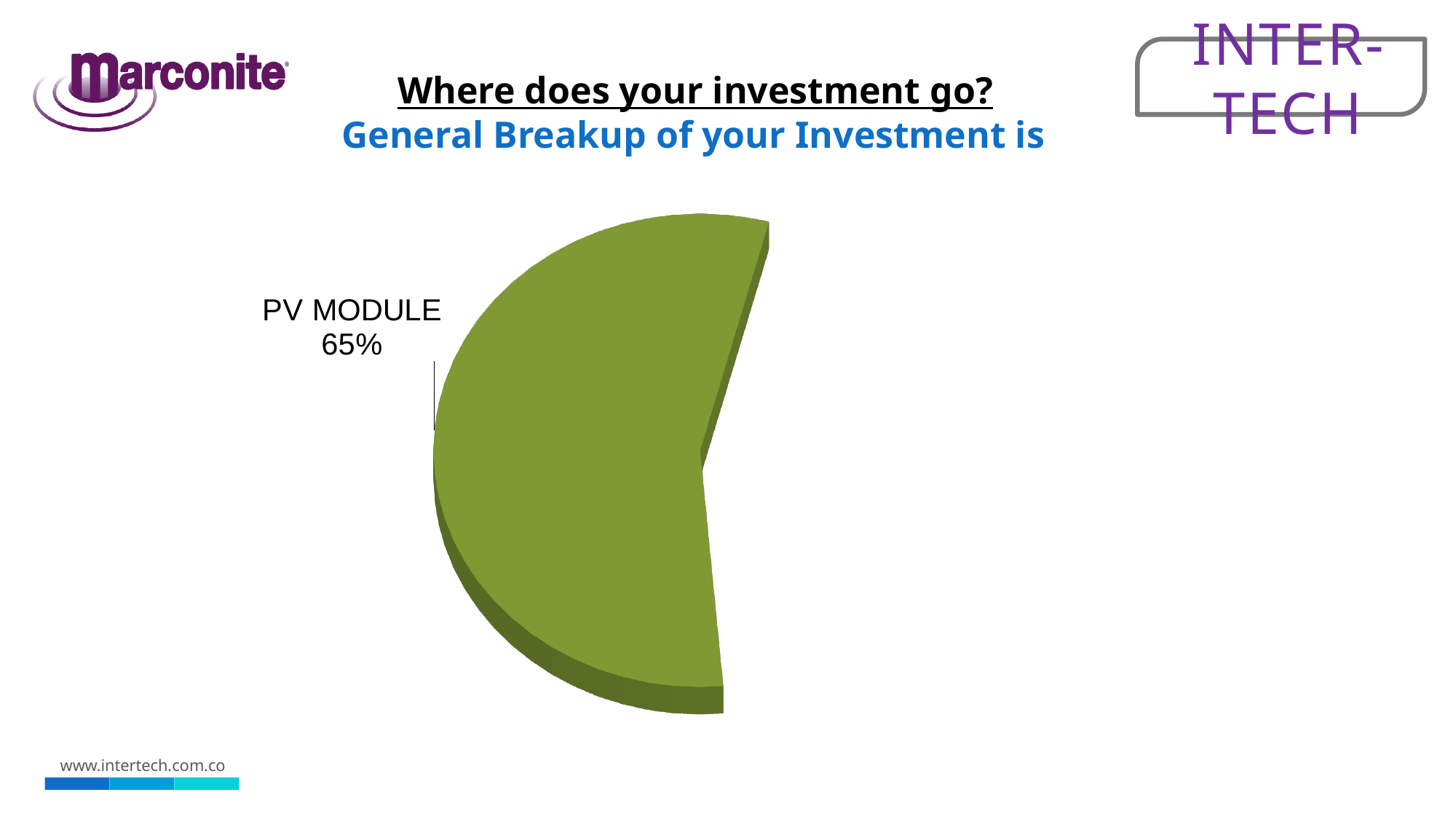
What colour is the PV MODULE slice of the pie chart? Green Is the share for PV MODULE greater or less than 50%? greater What share of the investment does the PV MODULE slice represent? 65% What kind of chart is shown on the slide? Pie chart Which category is labelled on the pie chart? PV MODULE What is the value shown for PV MODULE in the pie chart? 65%